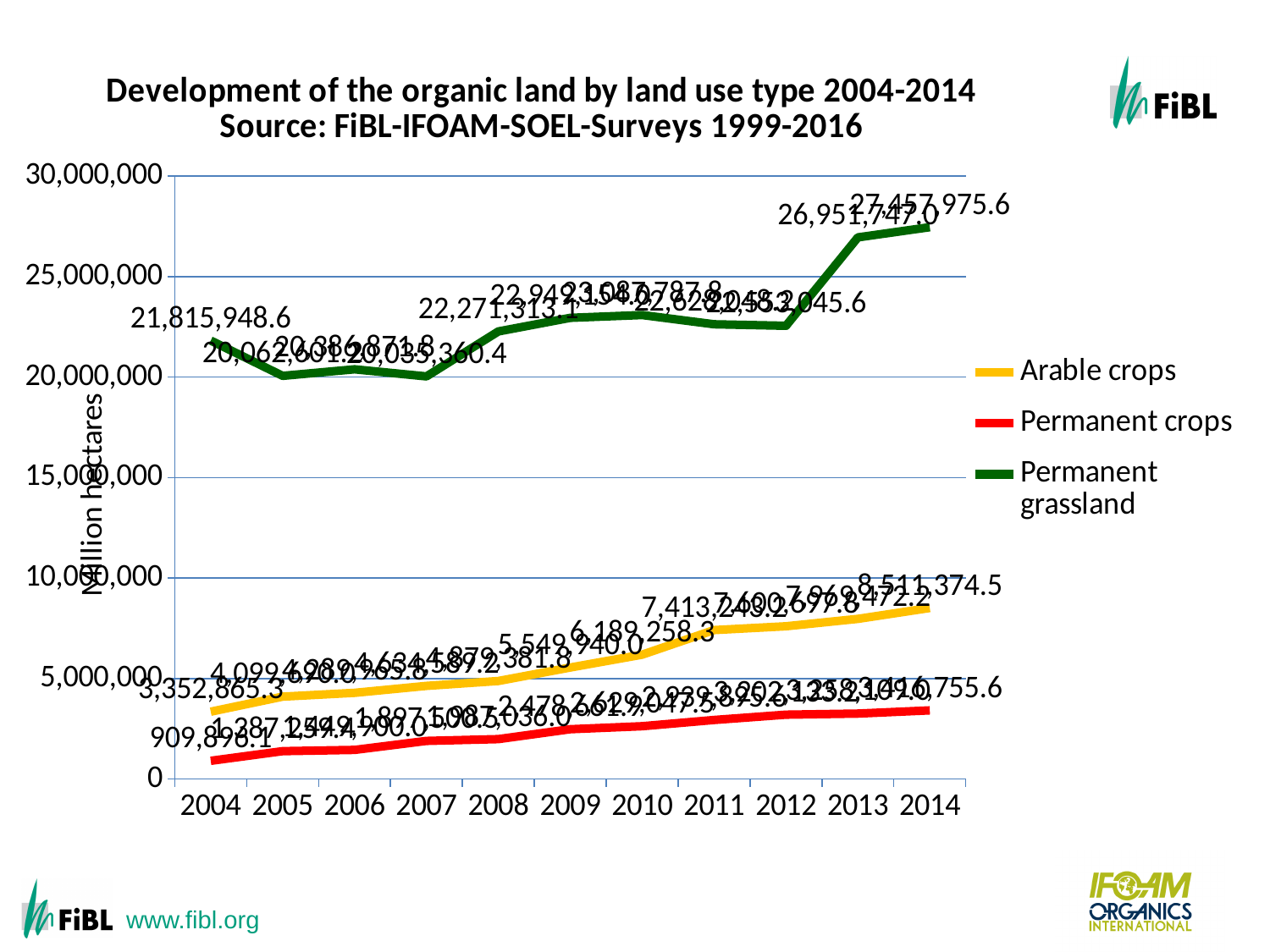
How many years are shown on the x axis? 11 What kind of chart is shown on the slide? Line chart What is the value for Permanent grassland in 2014? 27,457,975.6 What is the value for Arable crops in 2014? 8,511,374.5 By how much did Permanent grassland increase from 2004 to 2014? 5,642,027.0 Do the Arable crops values rise or fall from 2004 to 2014? rise What is the value for Permanent grassland in 2004? 21,815,948.6 Which series has the larger value in 2014, Arable crops or Permanent crops? Arable crops Is the value for Permanent crops in 2014 greater or less than 5,000,000? less How many series does the legend list? 3 What is the value for Arable crops in 2004? 3,352,865.3 In which year is the Permanent grassland value highest? 2014